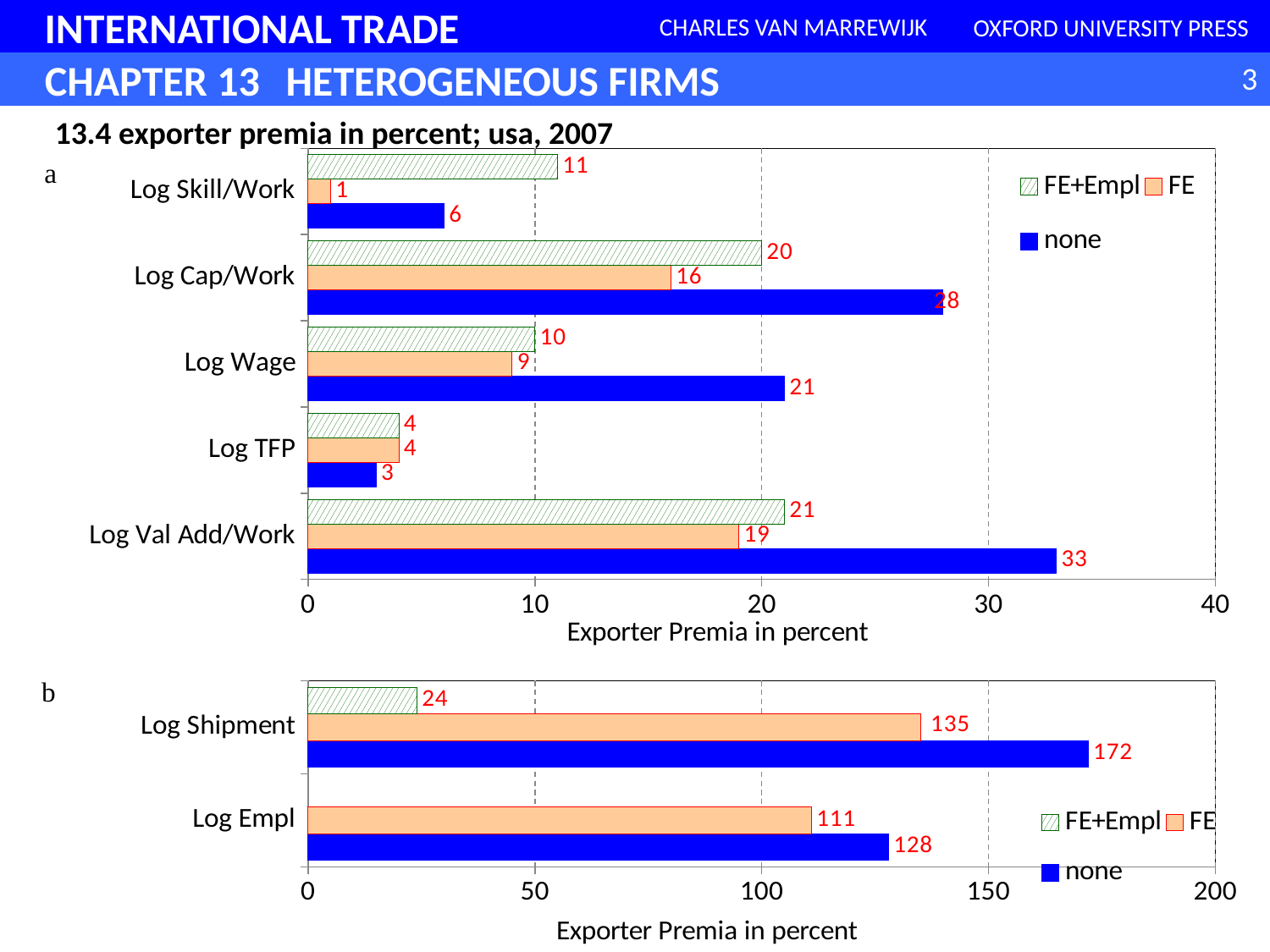
In chart b (bottom), what is the difference between the 'none' value and the FE value for Log Empl? 17 What kind of chart is chart a (top)? Bar chart In chart a (top), which is larger for Log Skill/Work: the FE+Empl value or the 'none' value? FE+Empl In chart b (bottom), what is the 'none' value for Log Shipment? 172 In chart a (top), what is the value of the FE series for Log Cap/Work? 16 In chart b (bottom), what is the FE value for Log Empl? 111 In chart a (top), what is the value of the 'none' series for Log Val Add/Work? 33 In chart b (bottom), how many series does the legend list? 3 In chart a (top), how many categories are shown on the vertical axis? 5 In chart a (top), which category has the lowest FE value? Log Skill/Work In chart a (top), which category has the highest 'none' value? Log Val Add/Work In chart a (top), what is the difference between the 'none' value and the FE+Empl value for Log Wage? 11